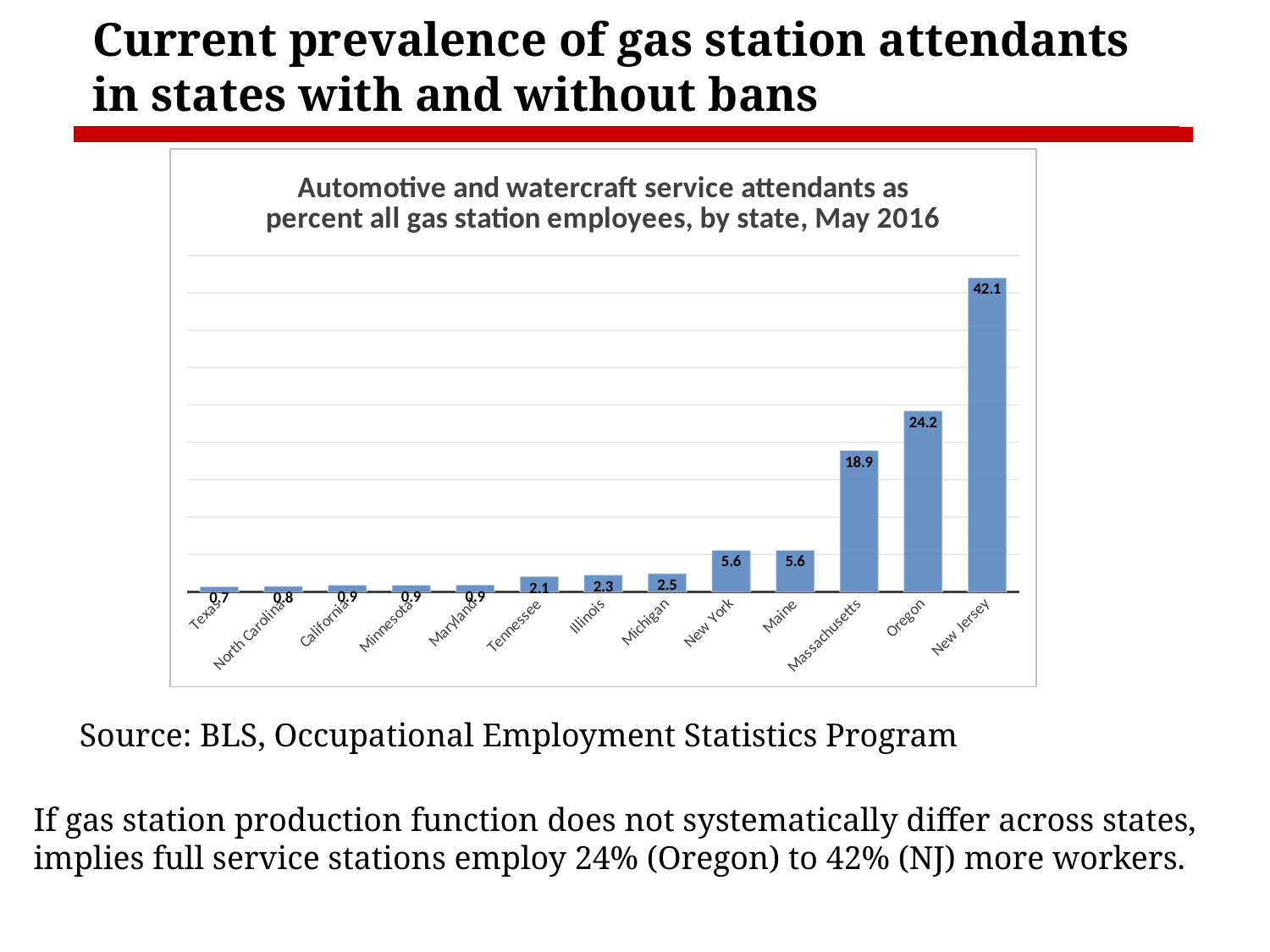
What is the difference between the values for Massachusetts and Michigan? 16.4 Which state has the lowest value? Texas How many states are shown in the chart? 13 What is the value for Oregon? 24.2 What is the value for Massachusetts? 18.9 What is the value for New Jersey? 42.1 Which is larger, the value for Oregon or the value for Massachusetts? Oregon What is the difference between the values for New Jersey and Oregon? 17.9 Which state has the highest value? New Jersey What kind of chart is shown on the slide? Bar chart Do the values rise or fall from left to right across the states? Rise What is the value for Tennessee? 2.1